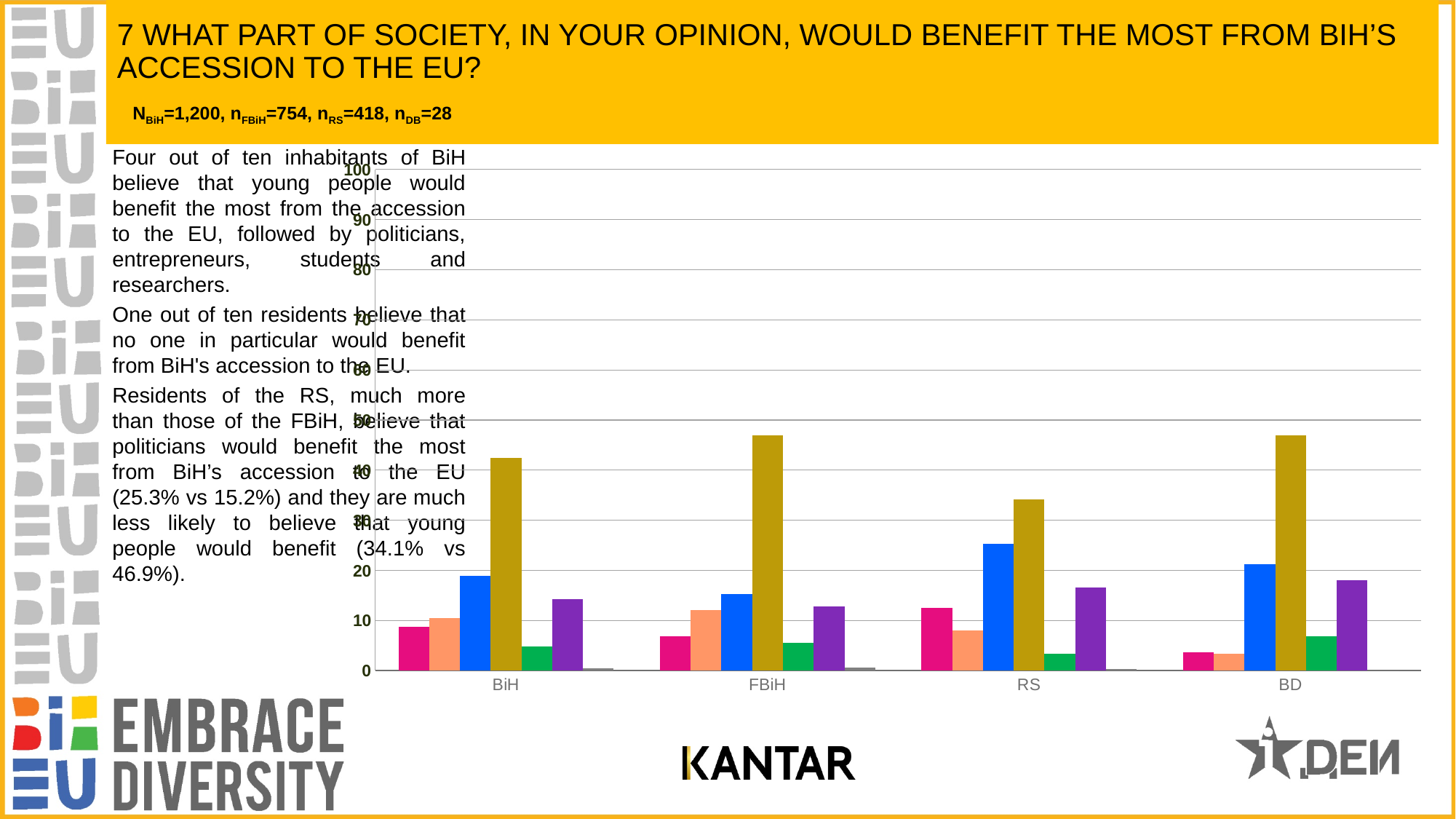
Which category has the lowest gold bar? RS Is the value of the gold bar for RS greater or less than 40? less How many categories are shown on the x axis of the chart? 4 What is the highest value shown on the y axis of the chart? 100 What kind of chart is shown on the slide? bar chart Is the value of the gold bar for BiH greater or less than 40? greater Is the value of the blue bar for RS greater or less than 20? greater What are the category labels on the x axis of the chart? BiH, FBiH, RS, BD For FBiH, which is larger: the pink bar or the orange bar? the orange bar Which category has the lowest pink bar? BD